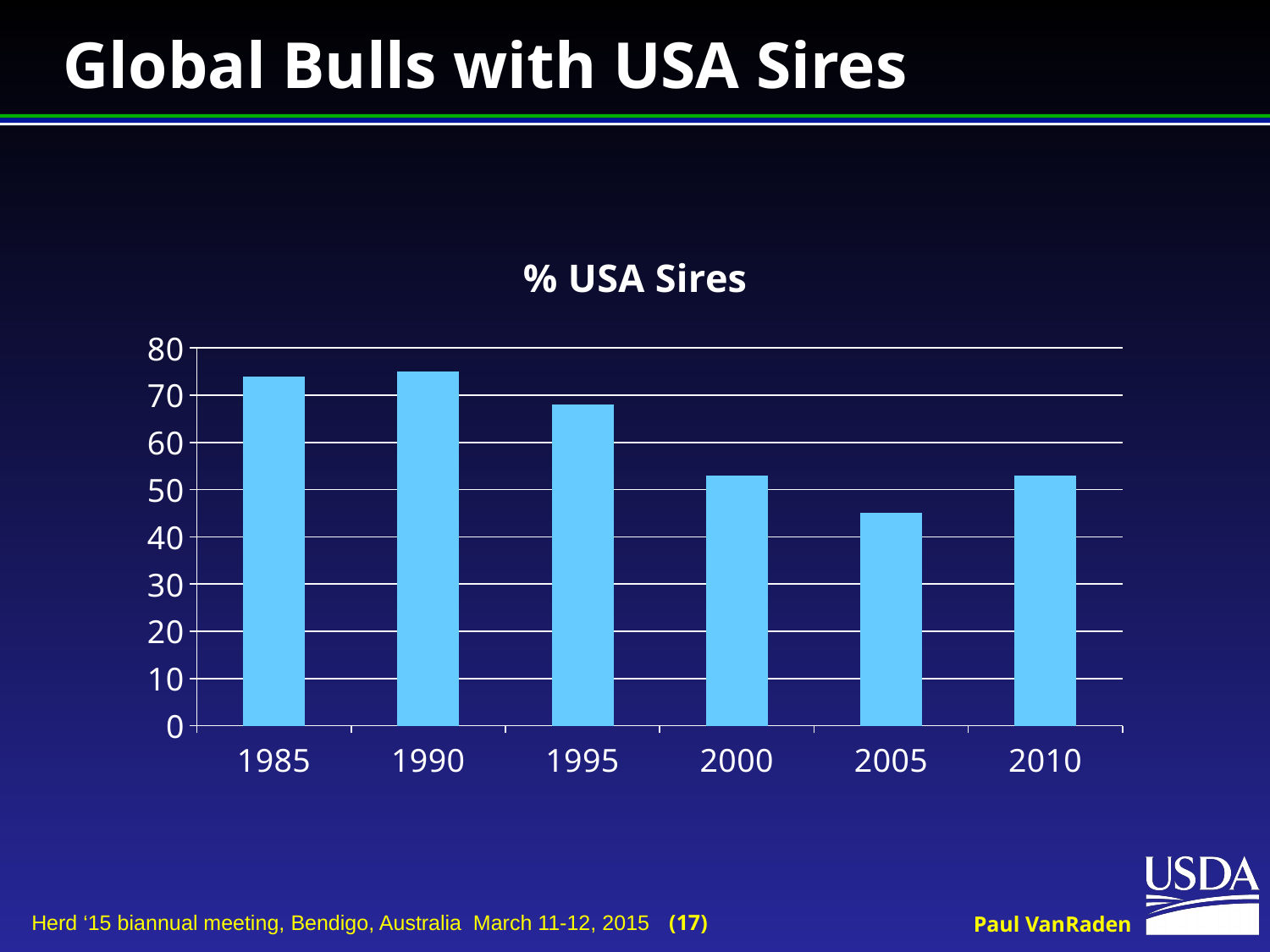
Which year has the lowest value in the chart? 2005 Do the values generally rise or fall from 1985 to 2005? fall What kind of chart is shown on the slide? bar chart Is the value for 1985 greater or less than 70? greater Is the value for 1995 greater or less than 70? less Is the value for 1990 greater or less than 70? greater What is the highest value shown on the y axis of the chart? 80 What is the title of the chart? % USA Sires Which is larger, the value for 1995 or the value for 2000? 1995 How many years are shown on the x axis of the chart? 6